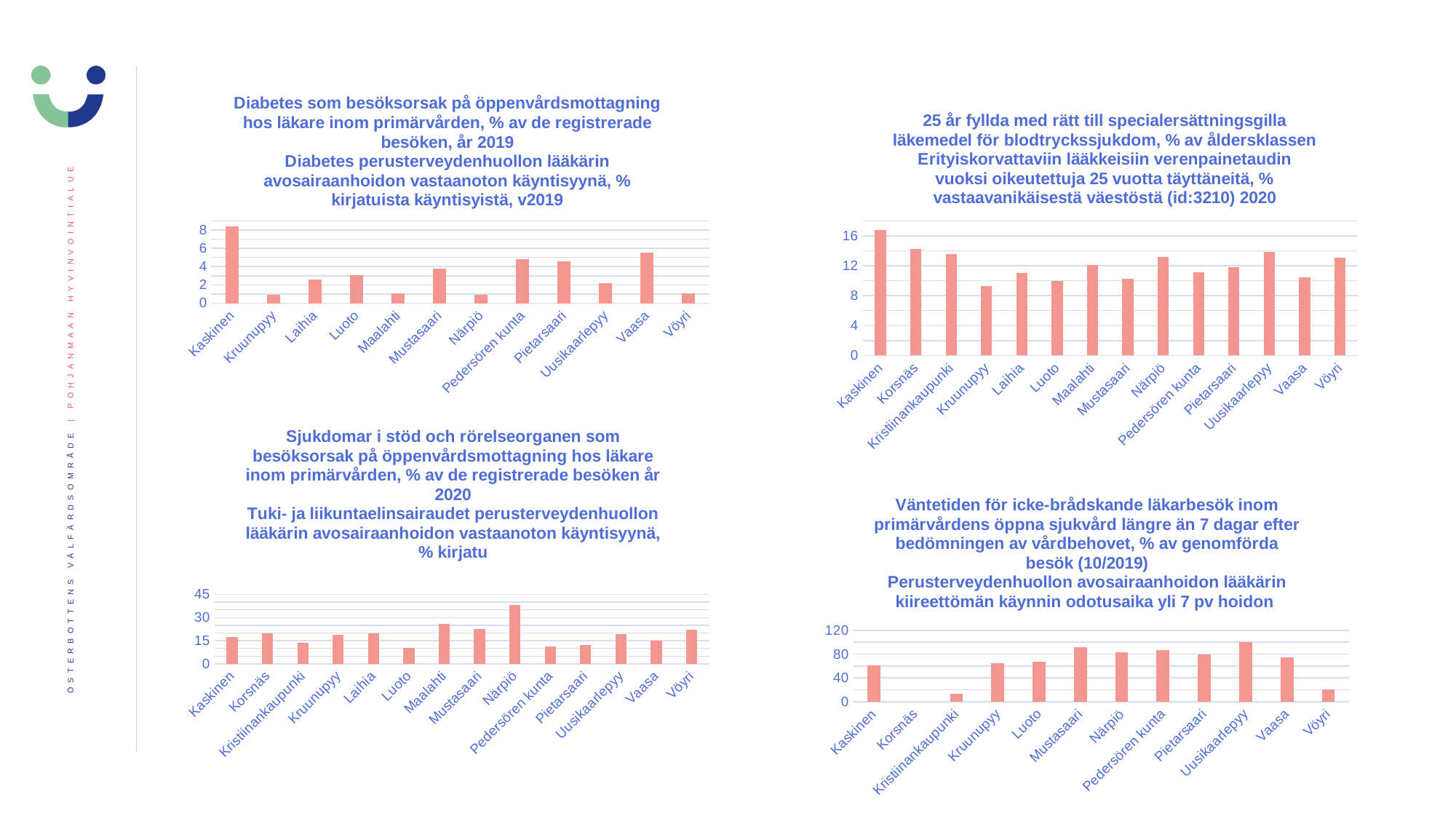
In the top-left chart (Diabetes som besöksorsak), is the value for Kruunupyy greater or less than 2? less What kind of chart is the top-left chart about diabetes as a reason for visits? bar chart In the bottom-right chart (Väntetiden för icke-brådskande läkarbesök), which is larger, the value for Kaskinen or the value for Mustasaari? Mustasaari How many municipalities are shown in the top-right chart (25 år fyllda med rätt till specialersättningsgilla läkemedel)? 14 In the bottom-left chart (Sjukdomar i stöd och rörelseorganen), which municipality has the highest value? Närpiö In the bottom-left chart (Sjukdomar i stöd och rörelseorganen), is the value for Närpiö greater or less than 30? greater In the top-right chart (25 år fyllda med rätt till specialersättningsgilla läkemedel), which municipality has the highest value? Kaskinen In the top-right chart (25 år fyllda med rätt till specialersättningsgilla läkemedel), is the value for Kaskinen greater or less than 16? greater In the top-right chart (25 år fyllda med rätt till specialersättningsgilla läkemedel), which municipality has the lowest value? Kruunupyy In the top-left chart (Diabetes som besöksorsak), which municipality has the highest value? Kaskinen